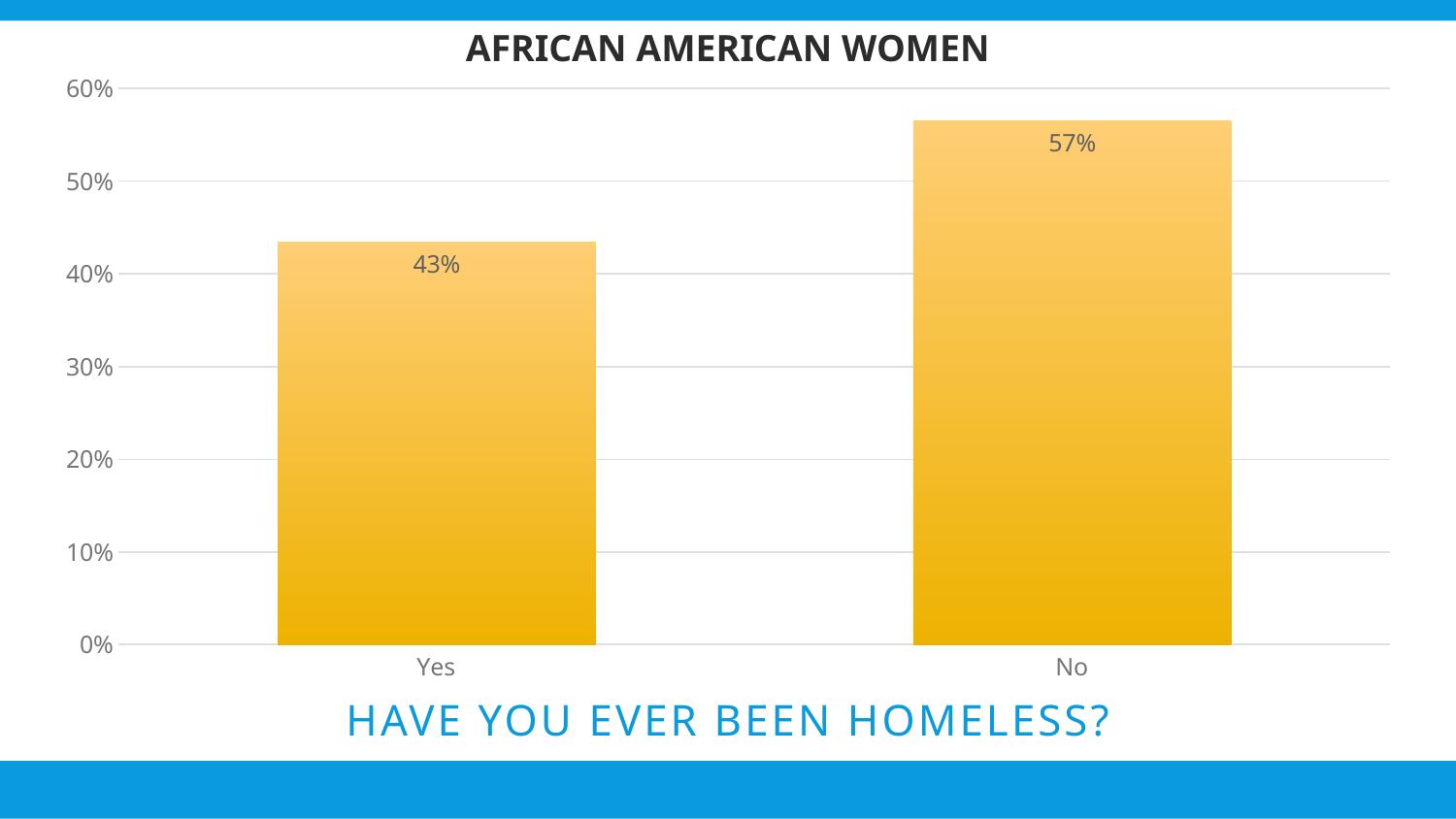
What kind of chart is shown on the slide? Bar chart What question is written below the chart's x axis? HAVE YOU EVER BEEN HOMELESS? Which category has the highest value? No Which is larger, the value for "Yes" or the value for "No"? No Which category has the lowest value? Yes What is the value for "Yes"? 43% What is the value for "No"? 57% What is the difference between the values for "No" and "Yes"? 14% What is the title of the chart? AFRICAN AMERICAN WOMEN How many categories are shown on the x axis? 2 Is the value for "No" greater or less than 50%? greater Is the value for "Yes" greater or less than 50%? less